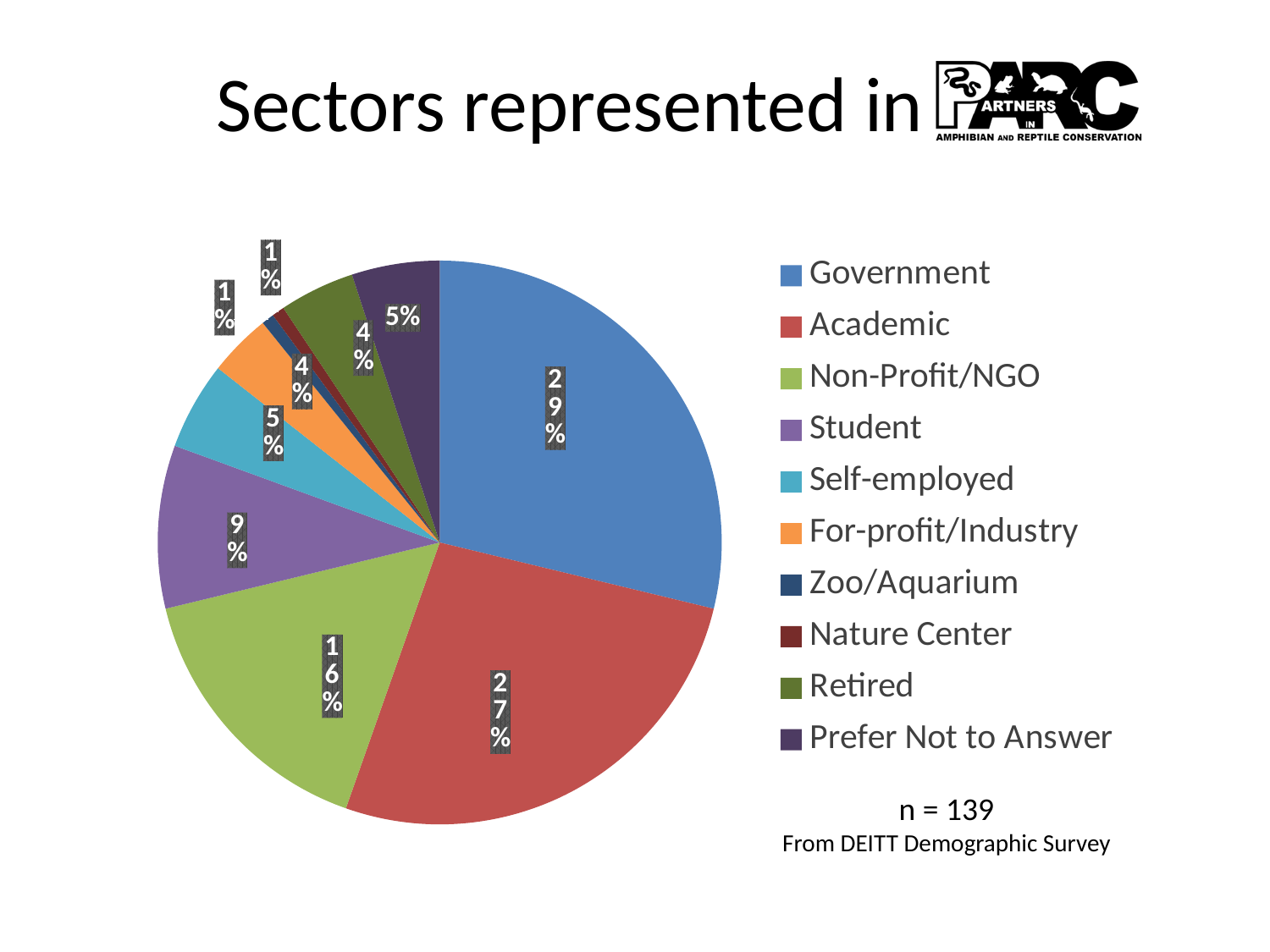
What is the sample size (n) stated on the slide? 139 What percentage of respondents are in the Government sector? 29% How many sectors are listed in the legend? 10 What is the difference in percentage points between Non-Profit/NGO and Student? 7 What percentage is shown for Prefer Not to Answer? 5% Which is larger, the share for Student or the share for Self-employed? Student What is the difference in percentage points between Government and Academic? 2 What percentage is shown for Student? 9% Which sector has the largest share of the pie? Government What share of the pie does the Academic sector represent? 27% What percentage is shown for Non-Profit/NGO? 16% What type of chart is shown on the slide? pie chart